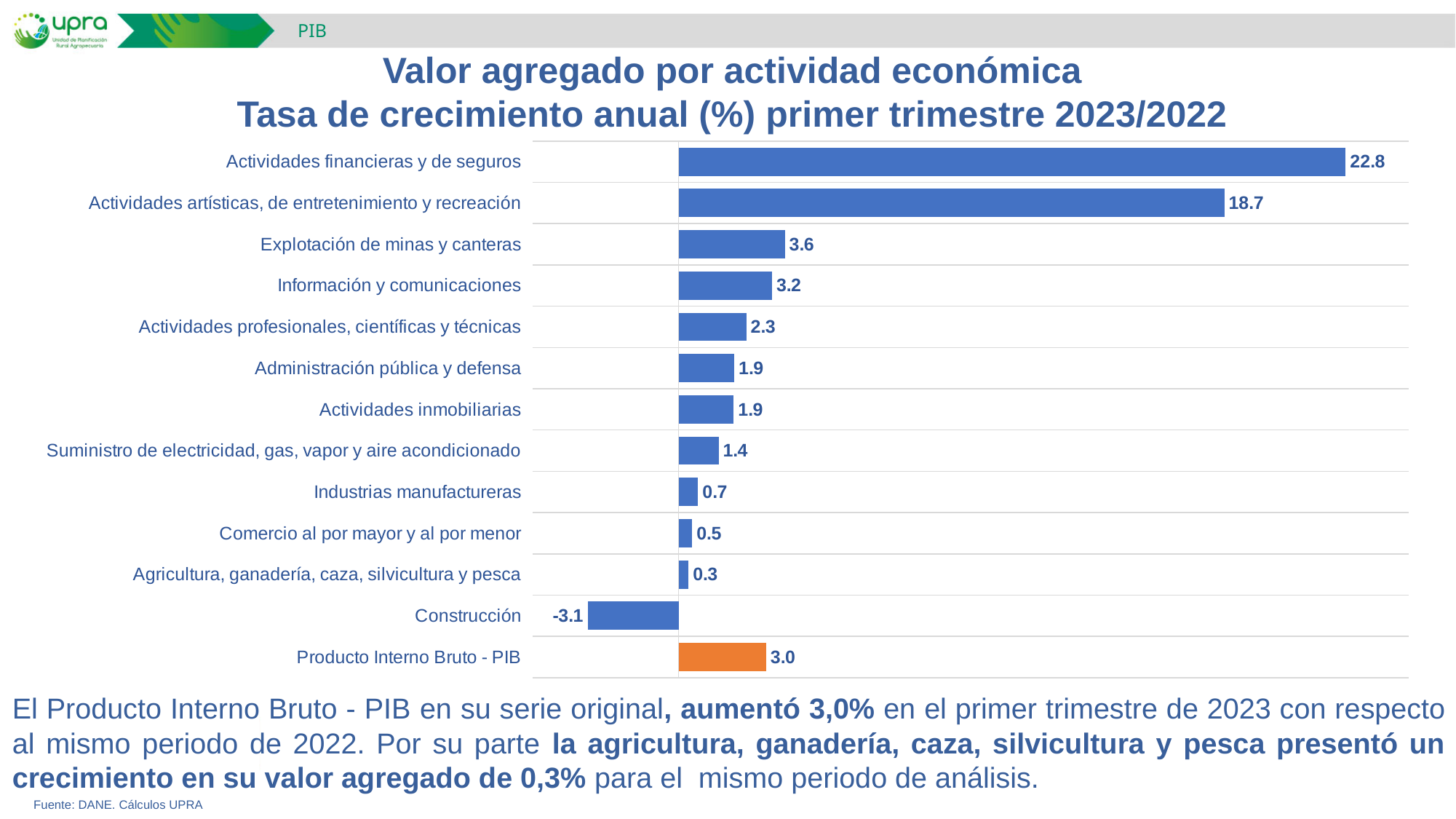
What kind of chart is shown on the slide? Bar chart What is the difference between the values for Actividades financieras y de seguros and Actividades artísticas, de entretenimiento y recreación? 4.1 What is the value shown for Producto Interno Bruto - PIB? 3.0 What is the annual growth rate shown for Actividades financieras y de seguros? 22.8 What value is shown for Agricultura, ganadería, caza, silvicultura y pesca? 0.3 Which bar is coloured orange instead of blue? Producto Interno Bruto - PIB Which has a larger value, Explotación de minas y canteras or Información y comunicaciones? Explotación de minas y canteras Which activity has the highest growth rate in the chart? Actividades financieras y de seguros Which activity has the lowest growth rate in the chart? Construcción How many categories are plotted in the chart? 13 What is the value shown for Construcción? -3.1 What is the difference between the value for Producto Interno Bruto - PIB and the value for Agricultura, ganadería, caza, silvicultura y pesca? 2.7